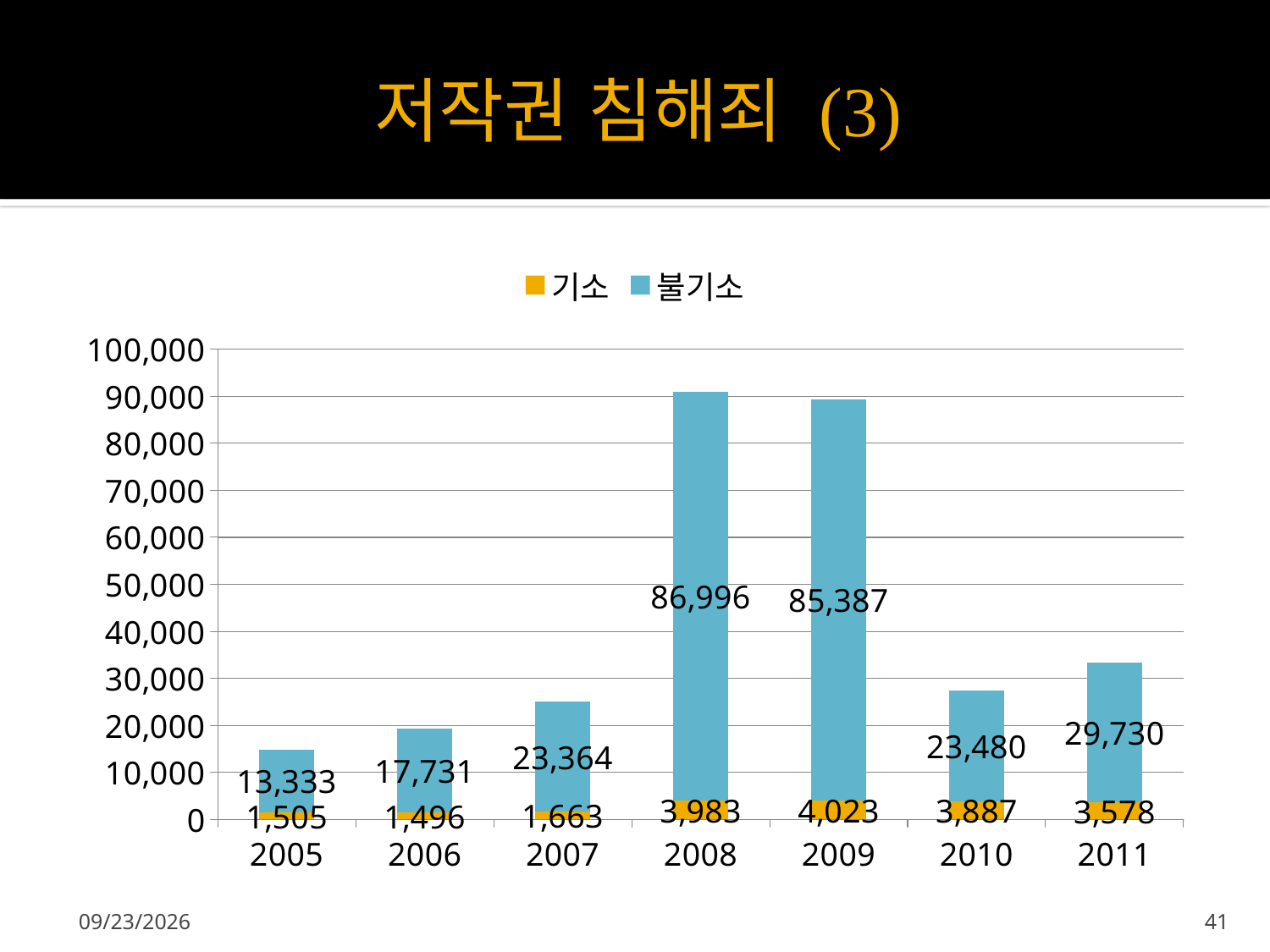
Which year has the highest 불기소 value? 2008 What kind of chart is shown on the slide? stacked bar chart What is the value of 불기소 for 2008? 86,996 How many years are shown on the x axis? 7 What is the difference between the 불기소 values for 2008 and 2009? 1,609 Which year has the lowest 기소 value? 2006 Is the total stacked bar for 2011 greater or less than 30,000? greater What is the value of 기소 for 2005? 1,505 How many series does the legend list? 2 What is the total of the stacked bar for 2008? 90,979 Which is larger, the 기소 value for 2009 or for 2010? 2009 What is the value of 불기소 for 2011? 29,730